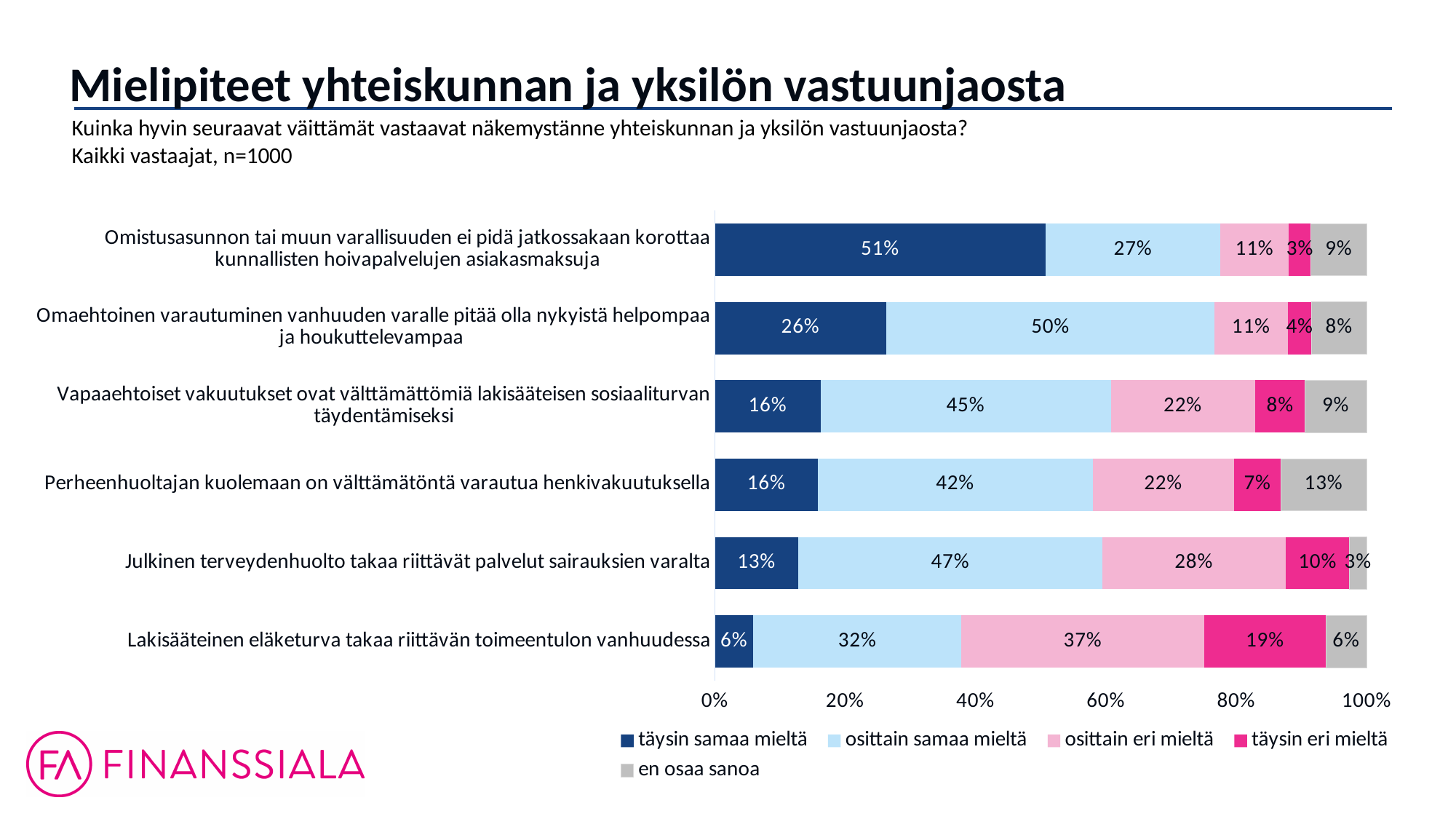
What is the 'osittain samaa mieltä' value for 'Omaehtoinen varautuminen vanhuuden varalle pitää olla nykyistä helpompaa ja houkuttelevampaa'? 50% Which statement has the lowest 'täysin samaa mieltä' share? Lakisääteinen eläketurva takaa riittävän toimeentulon vanhuudessa What kind of chart is shown on the slide? Stacked bar chart What is the difference between the 'osittain eri mieltä' values for 'Lakisääteinen eläketurva takaa riittävän toimeentulon vanhuudessa' and 'Julkinen terveydenhuolto takaa riittävät palvelut sairauksien varalta'? 9 percentage points What is the 'täysin eri mieltä' value for 'Lakisääteinen eläketurva takaa riittävän toimeentulon vanhuudessa'? 19% How many series does the legend list? 5 What is the 'täysin samaa mieltä' value for 'Omistusasunnon tai muun varallisuuden ei pidä jatkossakaan korottaa kunnallisten hoivapalvelujen asiakasmaksuja'? 51% How many statements (categories) are plotted in the chart? 6 What is the 'en osaa sanoa' value for 'Perheenhuoltajan kuolemaan on välttämätöntä varautua henkivakuutuksella'? 13% What is the combined share of 'täysin samaa mieltä' and 'osittain samaa mieltä' for 'Julkinen terveydenhuolto takaa riittävät palvelut sairauksien varalta'? 60% Which statement has the highest 'täysin samaa mieltä' share? Omistusasunnon tai muun varallisuuden ei pidä jatkossakaan korottaa kunnallisten hoivapalvelujen asiakasmaksuja Which is larger: the 'täysin eri mieltä' value for 'Vapaaehtoiset vakuutukset ovat välttämättömiä lakisääteisen sosiaaliturvan täydentämiseksi' or for 'Julkinen terveydenhuolto takaa riittävät palvelut sairauksien varalta'? Julkinen terveydenhuolto takaa riittävät palvelut sairauksien varalta